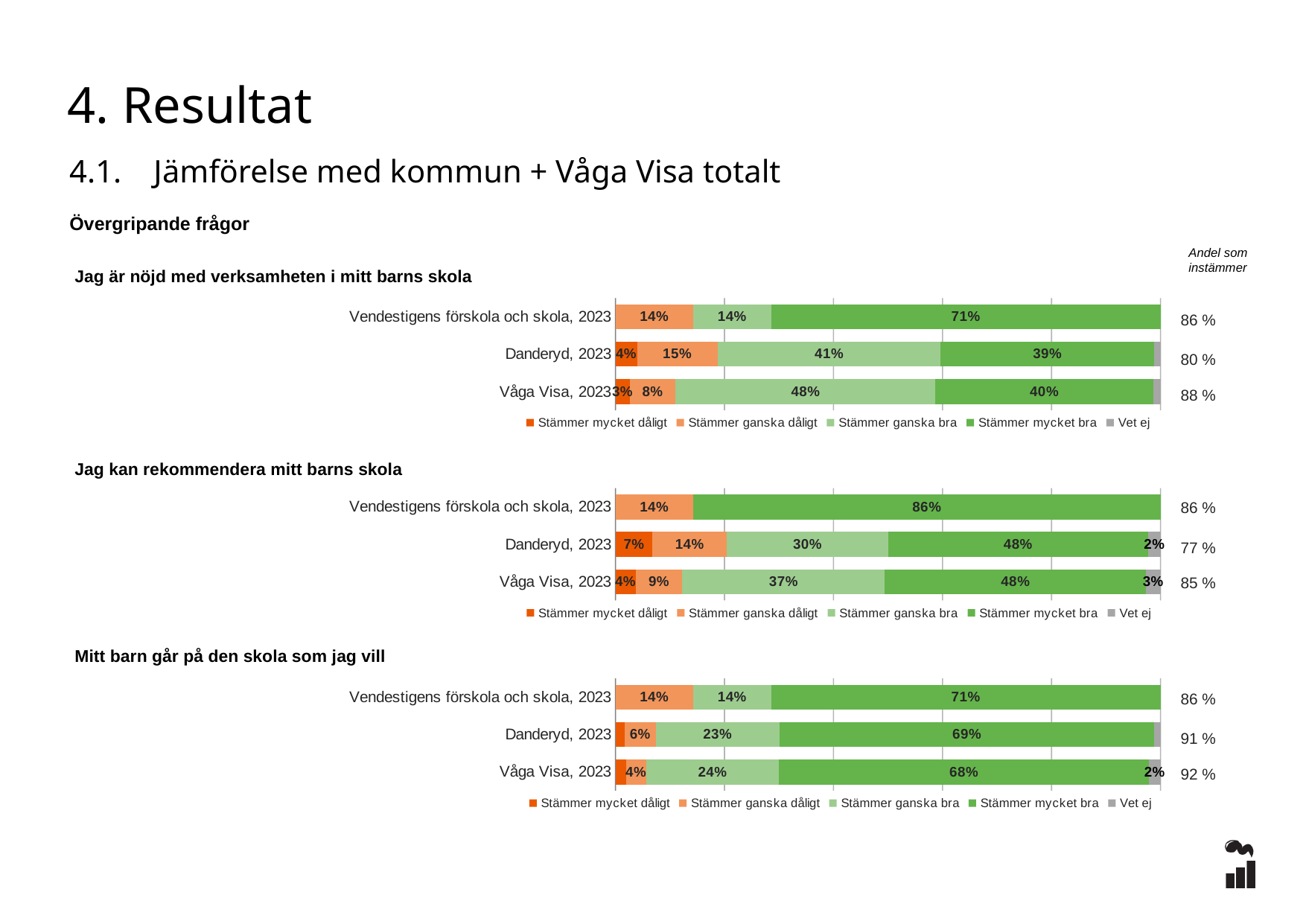
How many rows (categories) are shown in the chart 'Jag är nöjd med verksamheten i mitt barns skola'? 3 In the chart 'Jag kan rekommendera mitt barns skola', what is the 'Stämmer mycket bra' value for Vendestigens förskola och skola, 2023? 86% In the chart 'Mitt barn går på den skola som jag vill', which is larger: the 'Stämmer mycket bra' value for Danderyd, 2023 or for Vendestigens förskola och skola, 2023? Vendestigens förskola och skola, 2023 In the chart 'Jag kan rekommendera mitt barns skola', what is the difference between the 'Stämmer ganska bra' values for Våga Visa, 2023 and Danderyd, 2023? 7% In the chart 'Jag är nöjd med verksamheten i mitt barns skola', what is the 'Stämmer mycket bra' value for Vendestigens förskola och skola, 2023? 71% In the chart 'Mitt barn går på den skola som jag vill', what is the 'Andel som instämmer' value for Våga Visa, 2023? 92 % In the chart 'Jag är nöjd med verksamheten i mitt barns skola', what is the 'Stämmer ganska bra' value for Våga Visa, 2023? 48% In the chart 'Mitt barn går på den skola som jag vill', what is the 'Stämmer ganska bra' value for Danderyd, 2023? 23% In the chart 'Jag kan rekommendera mitt barns skola', what is the 'Stämmer mycket dåligt' value for Danderyd, 2023? 7% How many series does the legend of the chart 'Jag kan rekommendera mitt barns skola' list? 5 In the chart 'Jag är nöjd med verksamheten i mitt barns skola', which row has the highest 'Stämmer mycket bra' value? Vendestigens förskola och skola, 2023 What kind of chart is 'Mitt barn går på den skola som jag vill'? Stacked bar chart